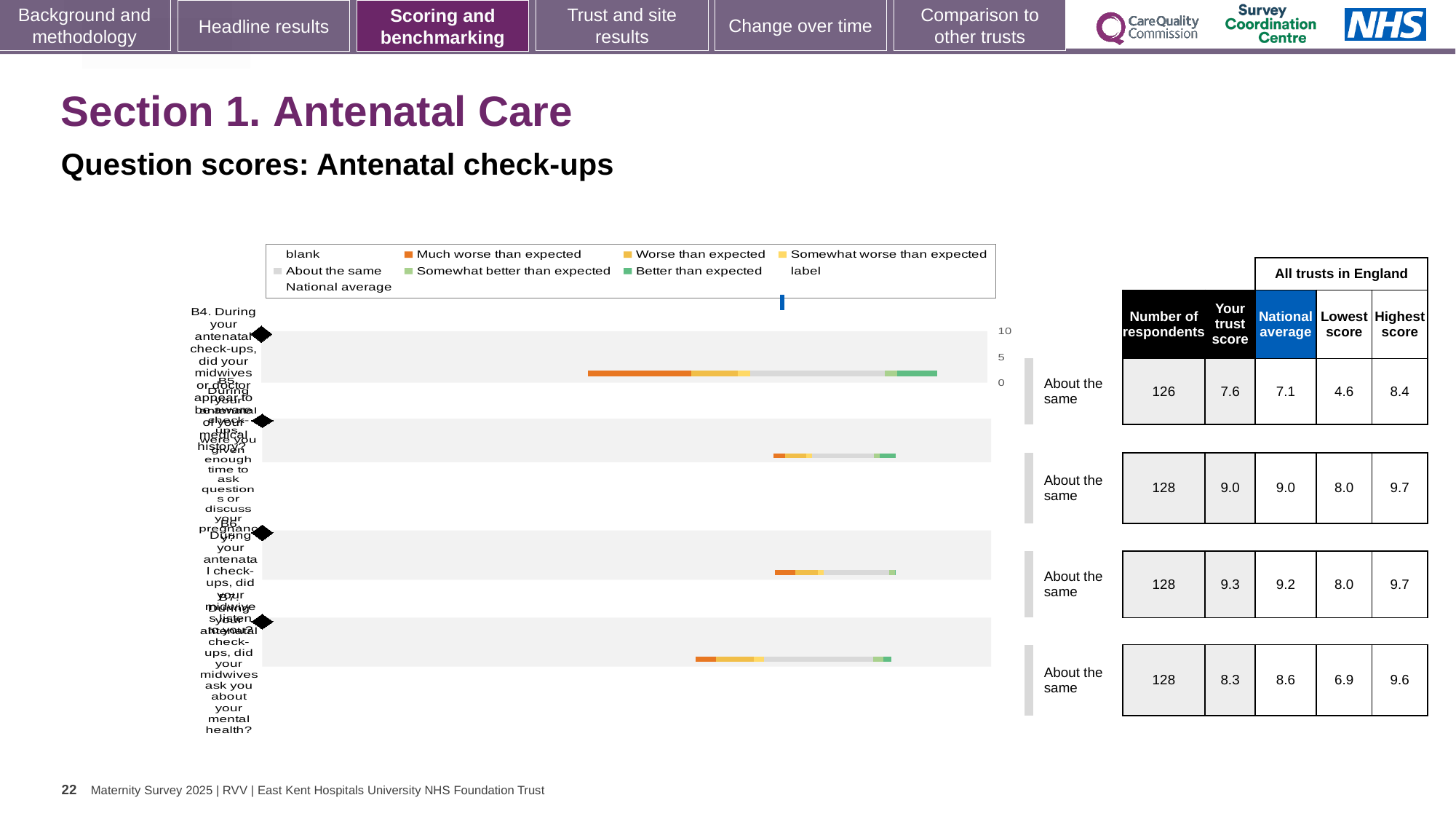
What kind of chart is shown on the slide? bar chart Which question has the highest trust score in the table beside the chart? B6 In the table beside the chart, what is the highest score across all trusts in England for question B7? 9.6 In the table beside the chart, how many respondents answered question B4? 126 How many question rows (bars) does the chart show? 4 What benchmark category is shown next to each bar in the chart? About the same What is the difference between the trust score and the national average for question B4? 0.5 Which question has the lowest trust score in the table beside the chart? B4 In the table beside the chart, what is the lowest score across all trusts in England for question B4? 4.6 For question B7, which is larger: the trust score or the national average? National average In the table beside the chart, what is the trust score for question B4? 7.6 In the table beside the chart, what is the national average for question B7? 8.6